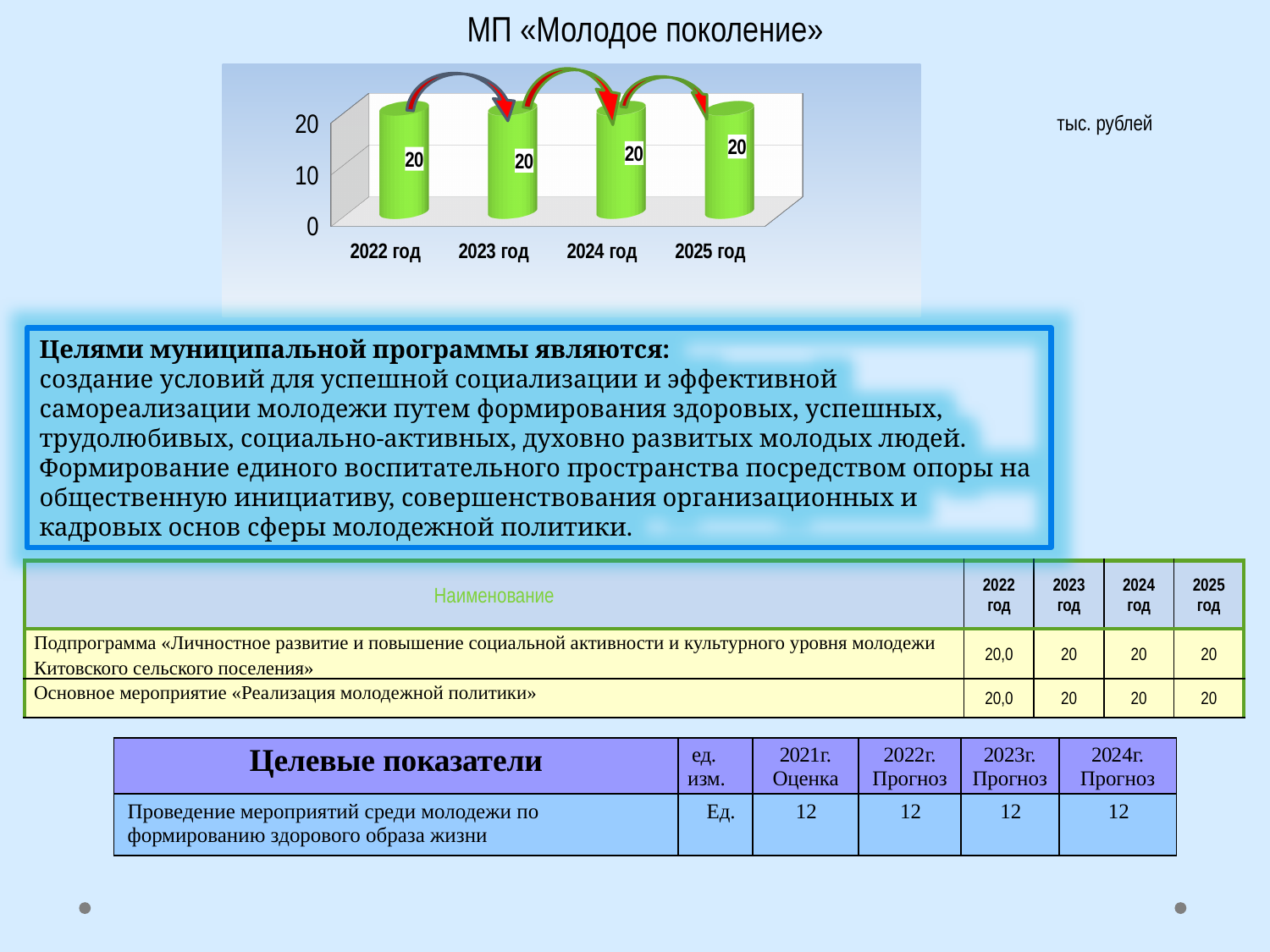
What is the value for 2023 год on the chart? 20 What is the difference between the values for 2022 год and 2025 год? 0 What is the value for 2022 год on the chart? 20 What kind of chart is shown on the slide? bar chart Do the values rise, fall or stay the same from 2022 год to 2025 год? stay the same Is the value for 2024 год greater or less than 10? greater What is the value for 2025 год on the chart? 20 How many categories (years) are shown on the chart? 4 What colour are the bars on the chart? green What unit of measurement is indicated next to the chart? тыс. рублей What is the value for 2024 год on the chart? 20